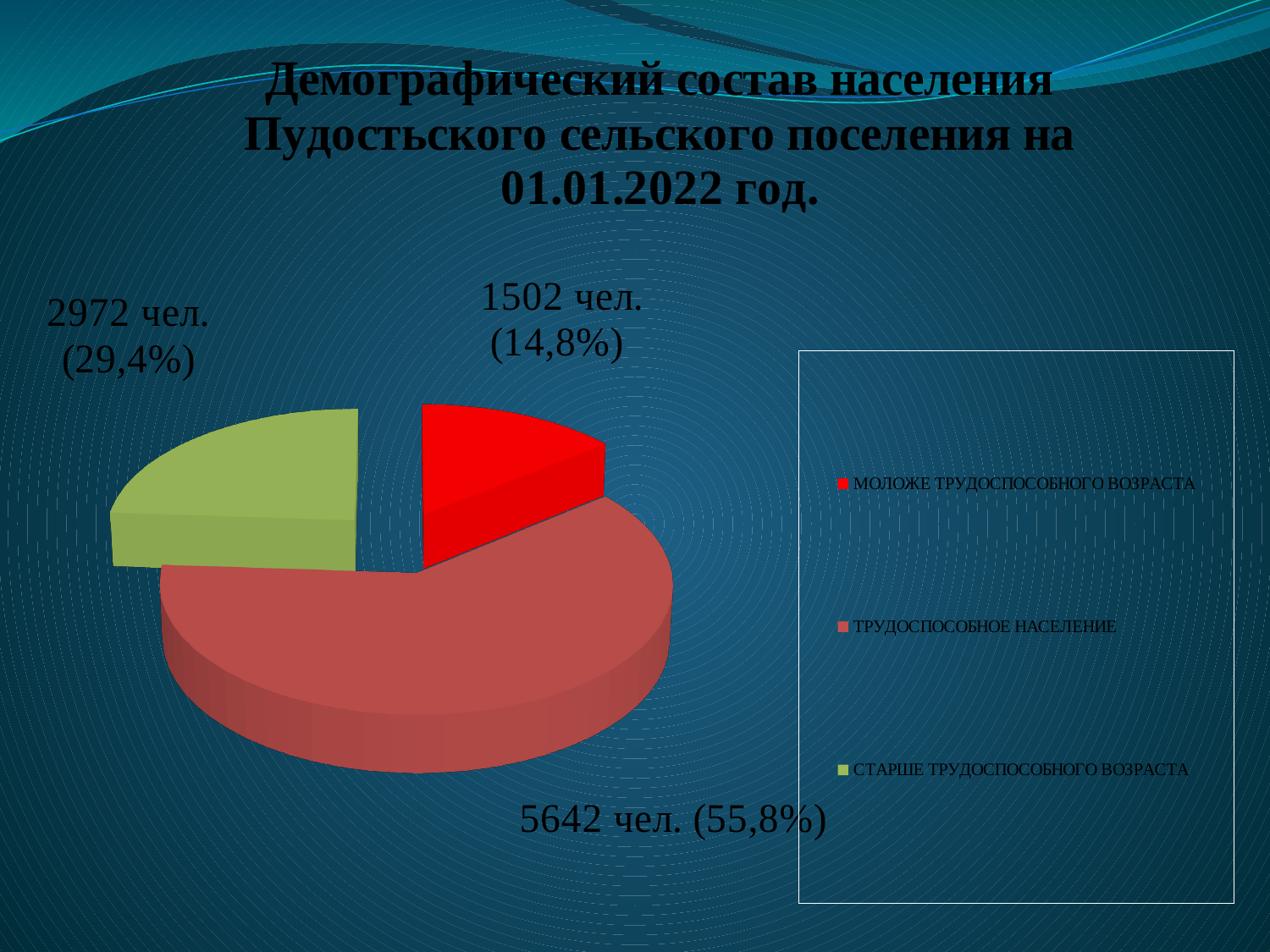
How many slices does the pie chart have? 3 What type of chart is shown on the slide? pie chart What share of the pie does the СТАРШЕ ТРУДОСПОСОБНОГО ВОЗРАСТА slice represent? 29,4% Which category has the smallest slice of the pie? МОЛОЖЕ ТРУДОСПОСОБНОГО ВОЗРАСТА How many people are in the МОЛОЖЕ ТРУДОСПОСОБНОГО ВОЗРАСТА category? 1502 чел. How many entries does the legend list? 3 What is the difference in people between ТРУДОСПОСОБНОЕ НАСЕЛЕНИЕ and СТАРШЕ ТРУДОСПОСОБНОГО ВОЗРАСТА? 2670 чел. What share of the pie does the ТРУДОСПОСОБНОЕ НАСЕЛЕНИЕ slice represent? 55,8% How many people are in the ТРУДОСПОСОБНОЕ НАСЕЛЕНИЕ category? 5642 чел. Which category has the largest slice of the pie? ТРУДОСПОСОБНОЕ НАСЕЛЕНИЕ Which colour represents МОЛОЖЕ ТРУДОСПОСОБНОГО ВОЗРАСТА in the legend? red How many people are in the СТАРШЕ ТРУДОСПОСОБНОГО ВОЗРАСТА category? 2972 чел.